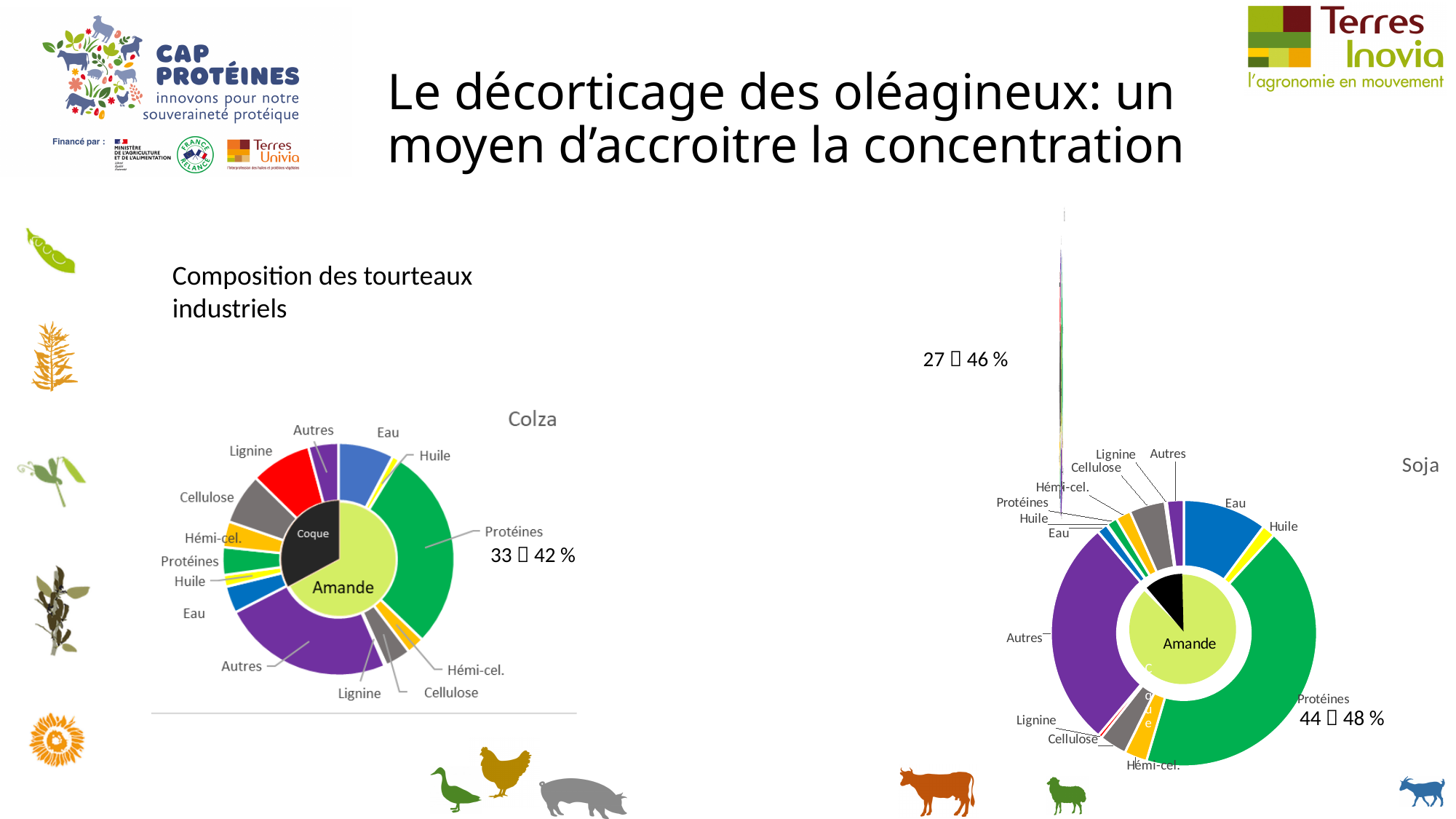
In the Colza chart, which inner-ring category is larger, Coque or Amande? Amande In the Soja chart, which outer-ring segment is the largest? Protéines What kind of chart is the Soja chart? doughnut (sunburst) chart In the Colza chart, which is larger, the Protéines segment of the Amande part or the Eau segment of the Amande part? Protéines How many labelled segments are in the outer ring of the Colza chart? 14 In the Colza chart, which two categories make up the inner ring? Coque and Amande In the Soja chart, which is larger, the Autres segment or the Lignine segment? Autres What is the title of the chart on the left? Colza How many labelled segments are in the outer ring of the Soja chart? 14 What kind of chart is the Colza chart? doughnut (sunburst) chart In the Colza chart, which outer-ring segment is the largest? Protéines